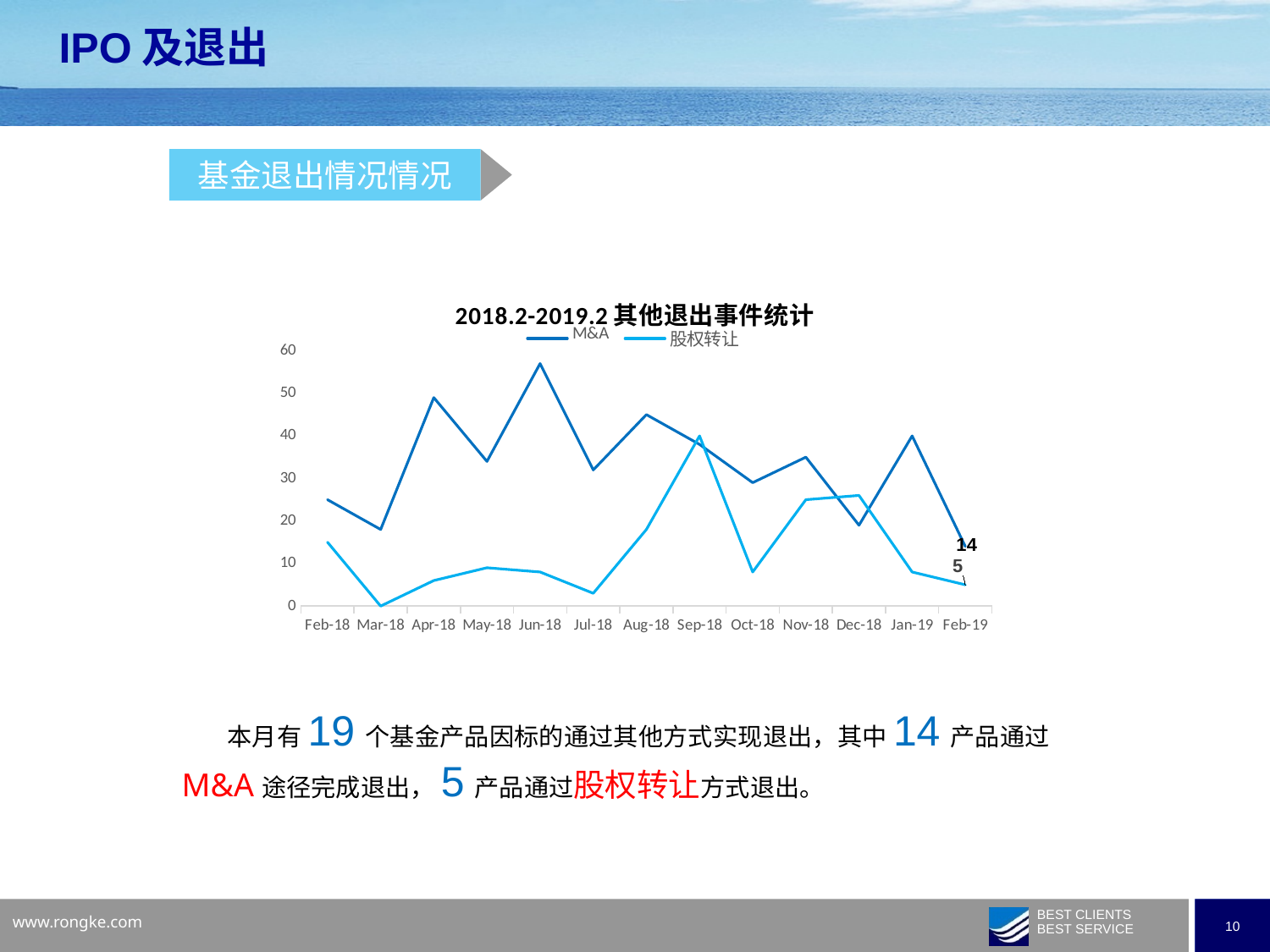
What is the difference between the M&A and 股权转让 values at Feb-19? 9 How many months are plotted along the x axis? 13 In which month does the 股权转让 series reach its lowest value? Mar-18 In which month does the M&A series reach its highest value? Jun-18 Is the 股权转让 value for Oct-18 greater or less than 10? less How many series does the legend list? 2 Is the M&A value for Jun-18 greater or less than 50? greater At Feb-19, which series has the larger value, M&A or 股权转让? M&A What is the value of the M&A series at Feb-19? 14 What is the value of the 股权转让 series at Feb-19? 5 What is the title of the chart? 2018.2-2019.2 其他退出事件统计 What kind of chart is shown on the slide? line chart